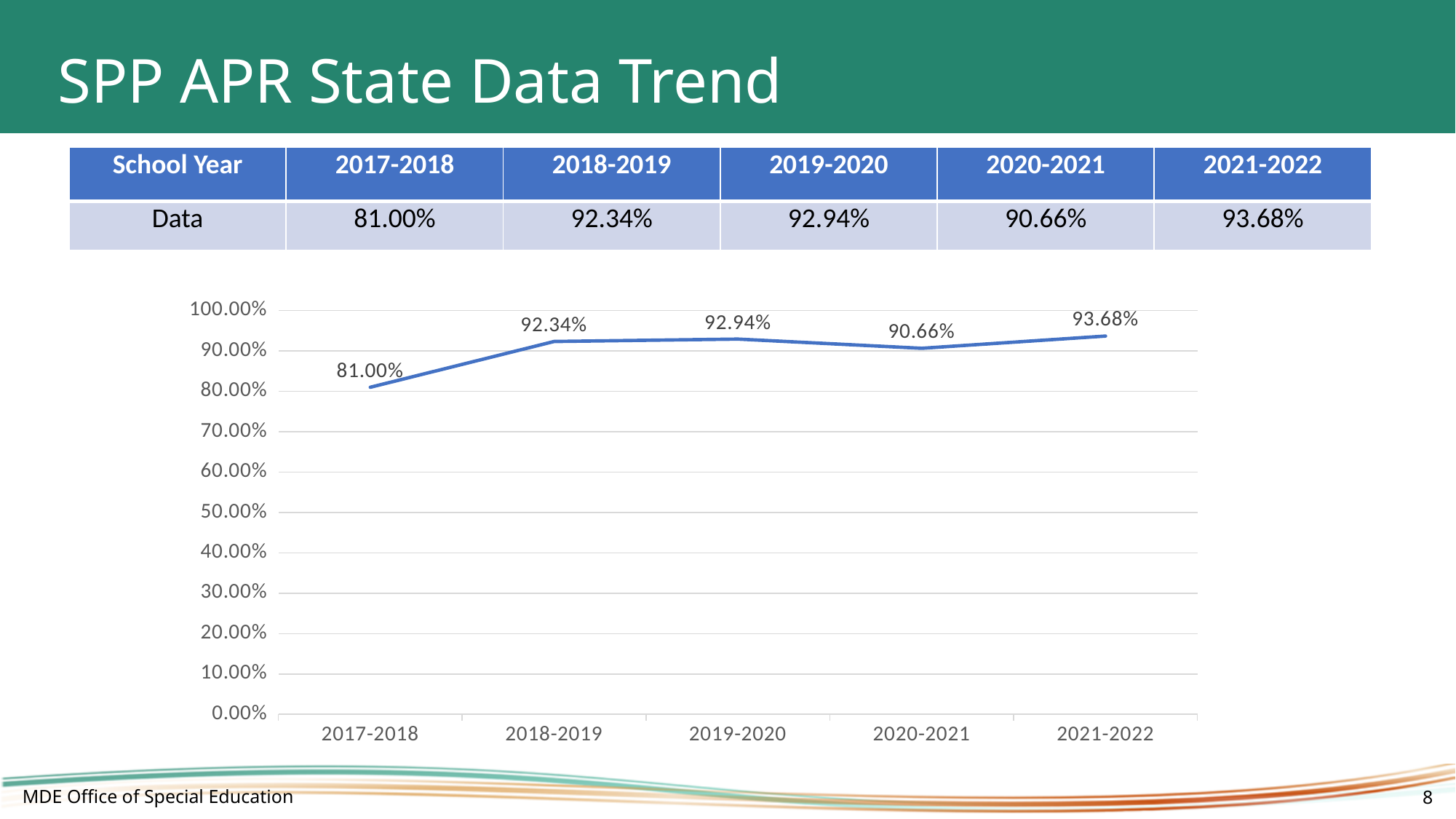
Which school year has the highest value? 2021-2022 Is the value for 2017-2018 greater or less than 90.00%? less Does the value rise or fall from 2019-2020 to 2020-2021? fall What is the difference between the values for 2018-2019 and 2017-2018? 11.34% Which school year has the lowest value? 2017-2018 How many school years are plotted on the chart? 5 What is the value for 2021-2022? 93.68% What is the title of the slide containing the chart? SPP APR State Data Trend What is the value for 2017-2018? 81.00% Which is larger, the value for 2019-2020 or the value for 2020-2021? 2019-2020 What is the value for 2020-2021? 90.66% What kind of chart is shown on the slide? line chart